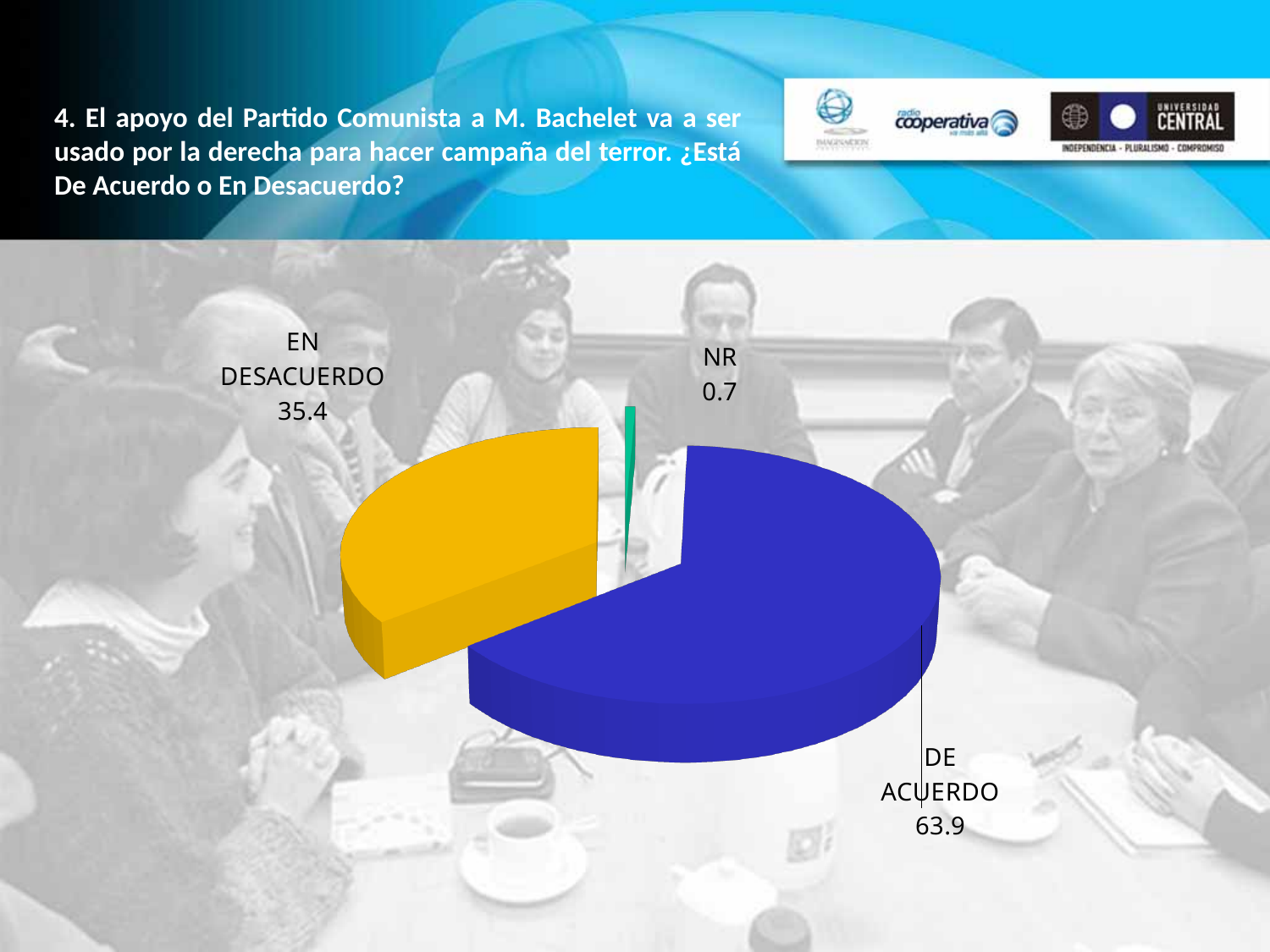
What is the value for DE ACUERDO? 63.9 Which category has the largest slice? DE ACUERDO Which is larger, EN DESACUERDO or NR? EN DESACUERDO How many slices does the pie chart have? 3 What is the value for NR? 0.7 What is the total of the three values shown on the pie chart? 100 What colour is the EN DESACUERDO slice? yellow Which category has the smallest slice? NR What kind of chart is shown on the slide? pie chart What is the value for EN DESACUERDO? 35.4 What colour is the DE ACUERDO slice? blue What is the difference between the values for DE ACUERDO and EN DESACUERDO? 28.5